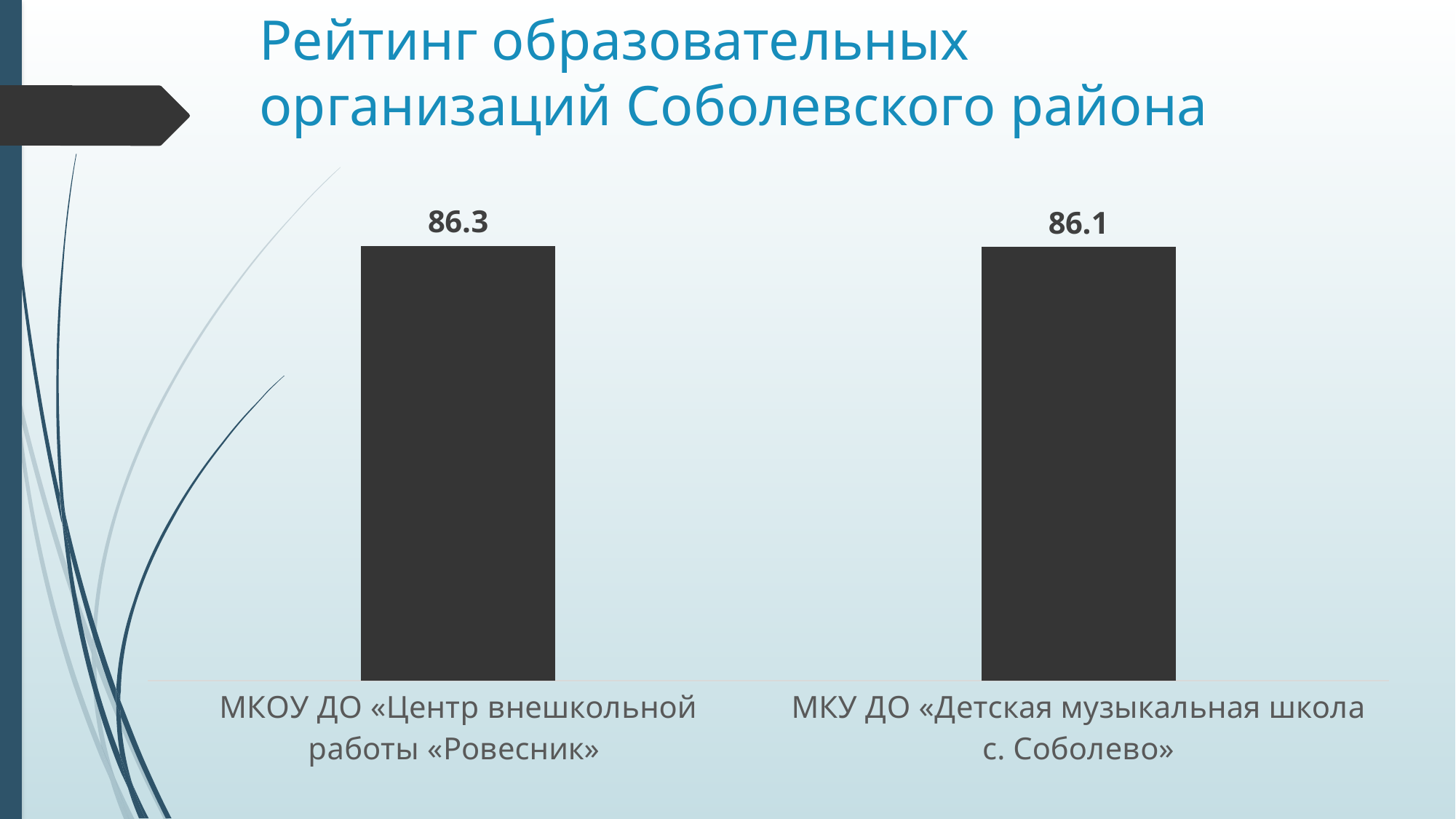
What is the value for МКУ ДО «Детская музыкальная школа с. Соболево»? 86.1 What is the difference between the values for «Ровесник» and «Детская музыкальная школа с. Соболево»? 0.2 What is the value for МКОУ ДО «Центр внешкольной работы «Ровесник»? 86.3 What is the title of the slide? Рейтинг образовательных организаций Соболевского района Which organisation has the highest value? МКОУ ДО «Центр внешкольной работы «Ровесник» What colour are the bars in the chart? Dark grey Which is larger: the value for «Ровесник» or the value for «Детская музыкальная школа с. Соболево»? «Ровесник» What kind of chart is shown on the slide? Bar chart How many organisations are shown in the chart? 2 Which organisation has the lowest value? МКУ ДО «Детская музыкальная школа с. Соболево»